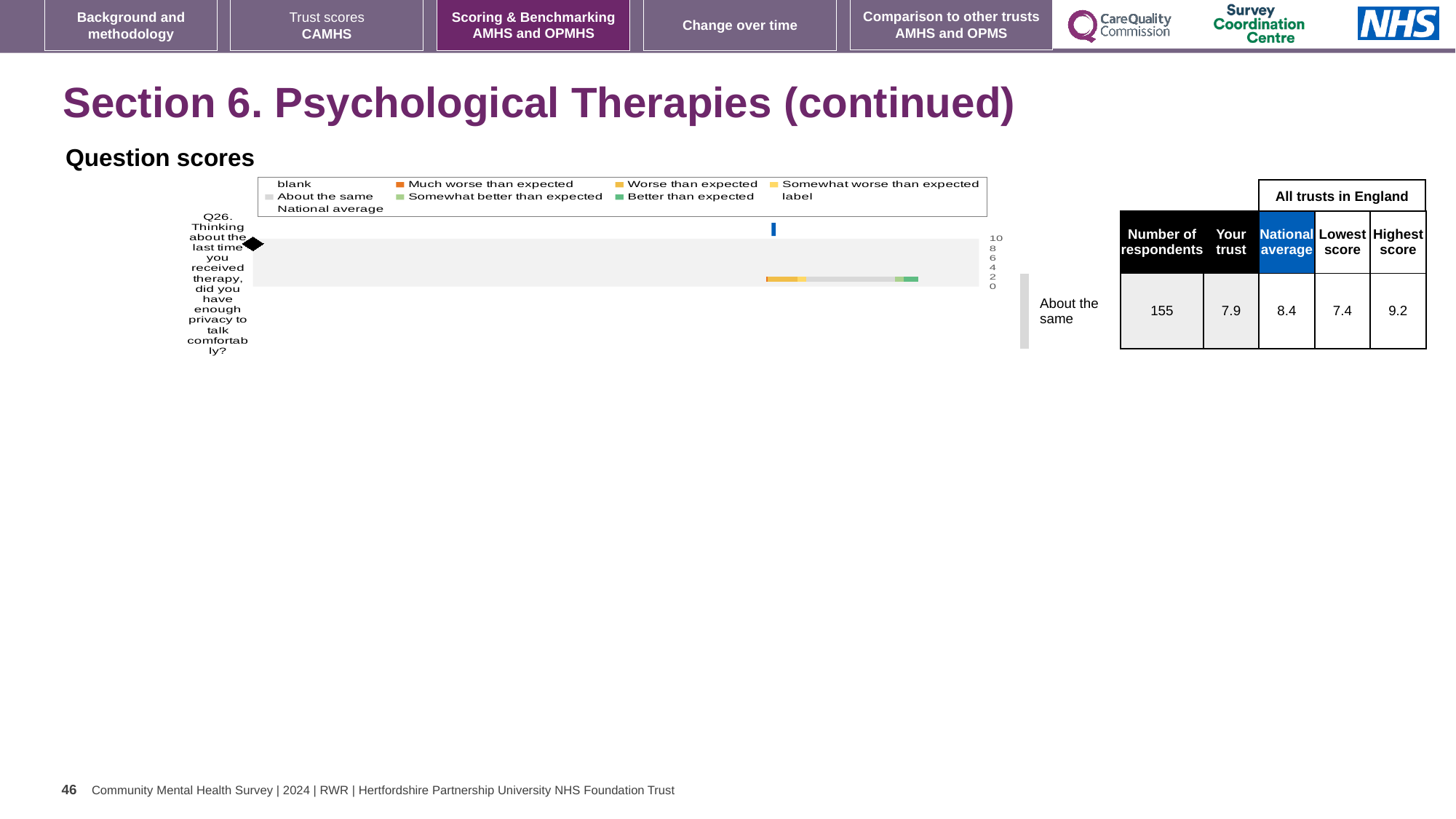
In the table beside the chart, what is the National average for Q26? 8.4 How many questions (categories) are plotted in the Question scores chart? 1 In the table beside the chart, what is the Number of respondents for Q26? 155 In the table beside the chart, what is the Lowest score among all trusts in England for Q26? 7.4 In the table beside the chart, what is the Highest score among all trusts in England for Q26? 9.2 Which question is plotted in the Question scores chart? Q26. Thinking about the last time you received therapy, did you have enough privacy to talk comfortably? What is the difference between the Highest score and the Lowest score for Q26? 1.8 Which is larger for Q26, the 'Your trust' score or the National average? National average What is the difference between the National average and the 'Your trust' score for Q26? 0.5 In the table beside the chart, what is the 'Your trust' score for Q26? 7.9 What kind of chart is shown under 'Question scores'? bar chart What is the highest value shown on the axis of the Question scores chart? 10